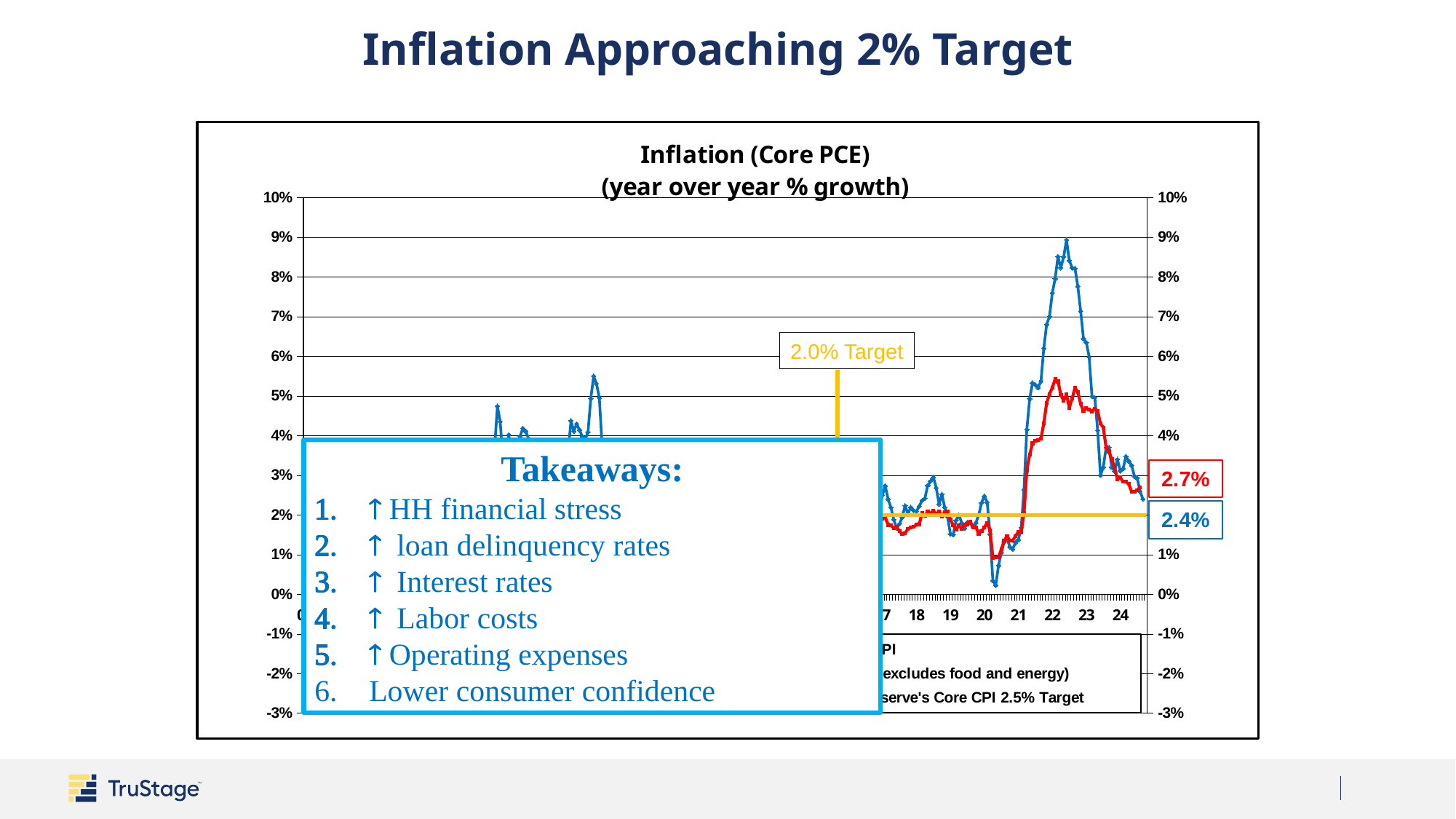
What is the latest value labelled for the blue line? 2.4% What target level is marked by the yellow horizontal line? 2.0% Target Is the peak of the blue line around 2022 greater or less than 8%? greater What kind of chart is shown on the slide? line chart Which line has the higher latest labelled value, the red line or the blue line? red line Is the latest labelled value of the blue line (2.4%) greater or less than the 2.0% target? greater What is the latest value labelled for the red line? 2.7% What is the title of the chart? Inflation (Core PCE) (year over year % growth) Is the lowest point of the blue line around 2020 greater or less than 1%? less What is the difference between the latest labelled values of the red line (2.7%) and the blue line (2.4%)? 0.3% Do the values of the blue line rise or fall from their 2022 peak to 2024? fall Is the peak of the red line around 2022 greater or less than 5%? greater